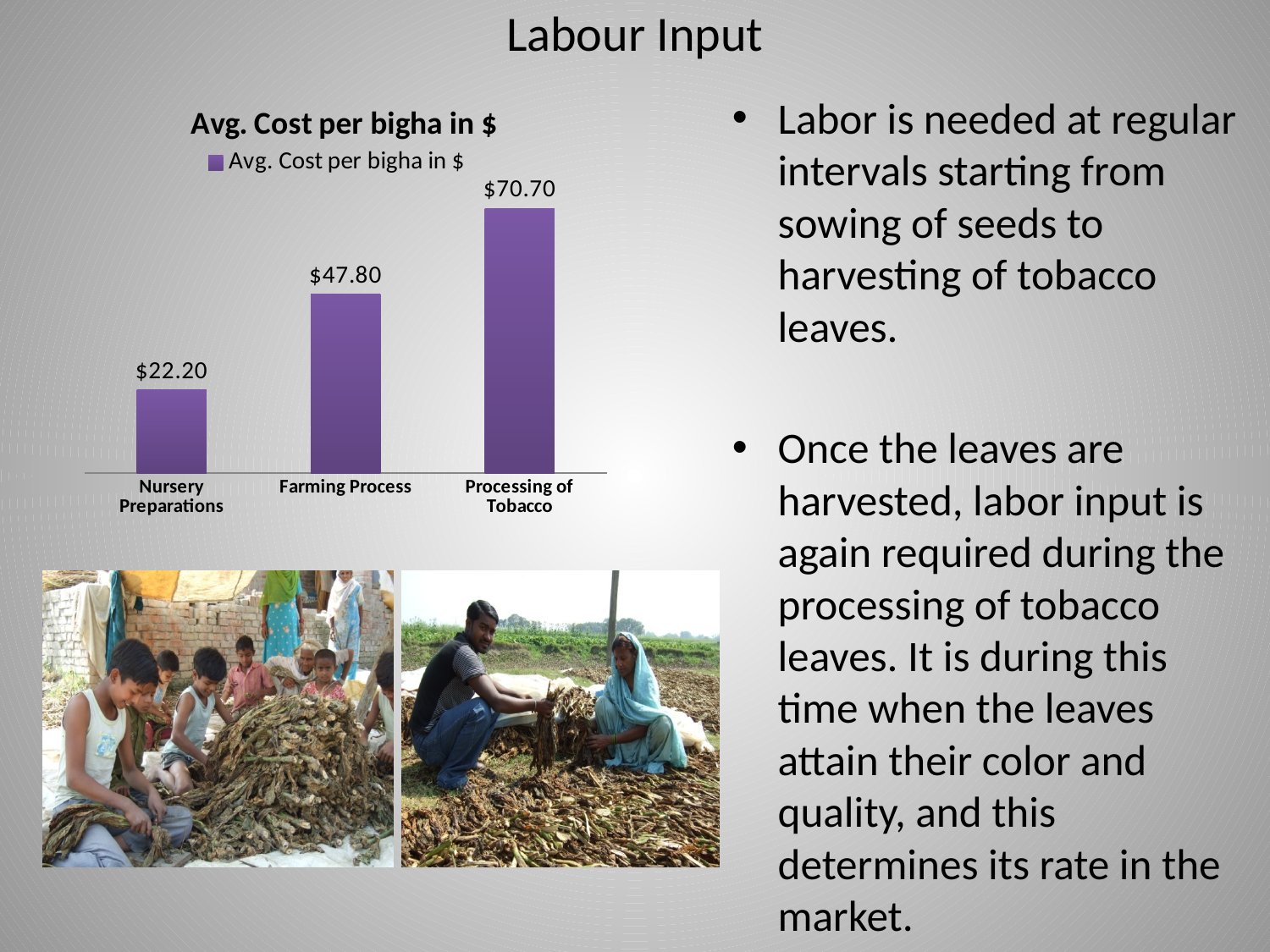
What is the average cost per bigha for Processing of Tobacco? $70.70 How many categories are shown in the chart? 3 Which category has the lowest average cost per bigha? Nursery Preparations Which has a higher average cost per bigha, Farming Process or Nursery Preparations? Farming Process Which category has the highest average cost per bigha? Processing of Tobacco What kind of chart is shown on the slide? Bar chart What is the difference in average cost per bigha between Processing of Tobacco and Farming Process? $22.90 What is the difference in average cost per bigha between Farming Process and Nursery Preparations? $25.60 What is the average cost per bigha for Farming Process? $47.80 What is the title of the chart? Avg. Cost per bigha in $ What is the average cost per bigha for Nursery Preparations? $22.20 How many series does the chart legend list? 1